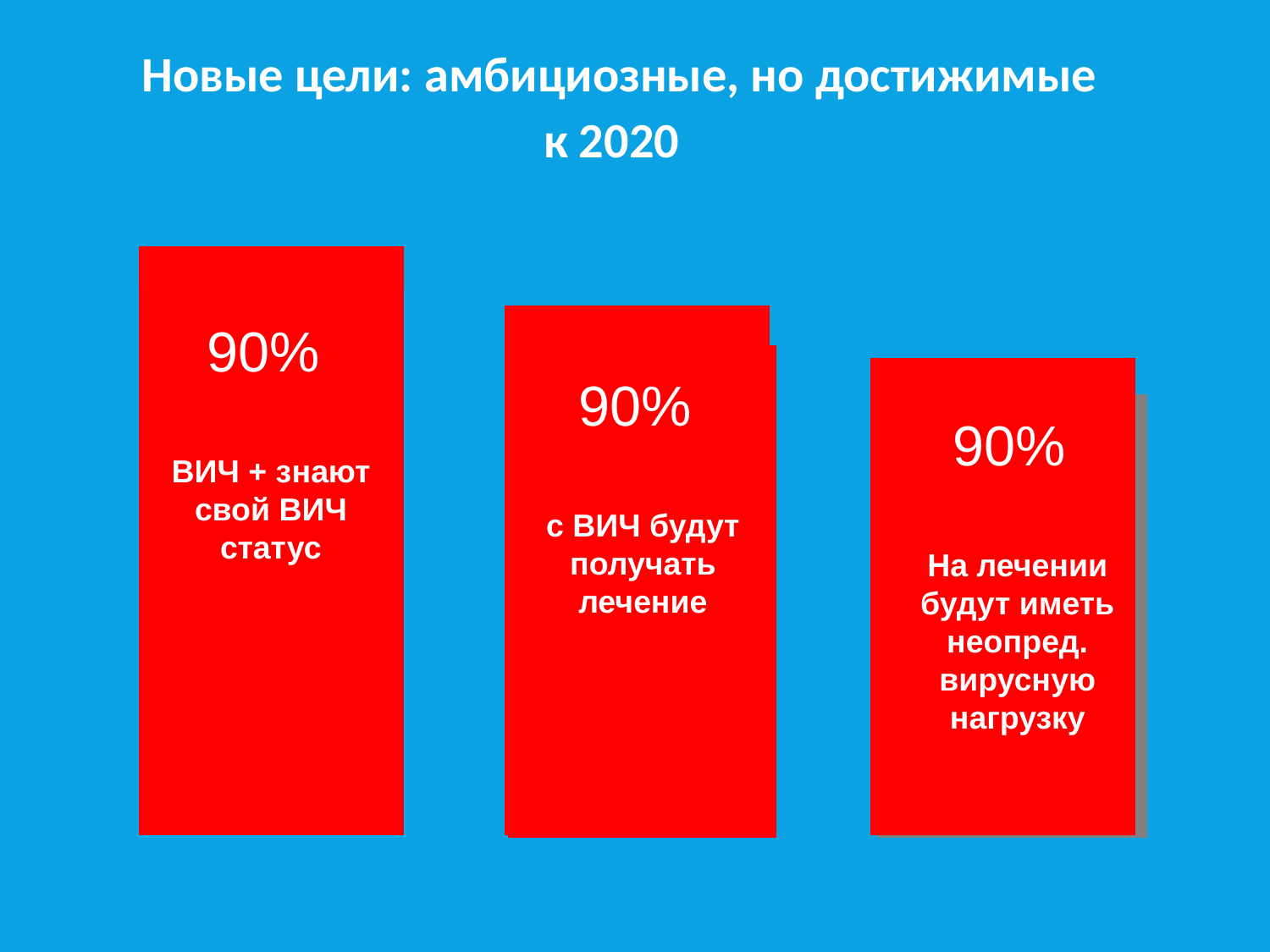
What value is shown on the bar labelled "ВИЧ + знают свой ВИЧ статус"? 90% What value is shown on the bar labelled "На лечении будут иметь неопред. вирусную нагрузку"? 90% What colour are the bars on the slide? red What is the title of the slide? Новые цели: амбициозные, но достижимые к 2020 What value is shown on the bar labelled "с ВИЧ будут получать лечение"? 90% What kind of chart is shown on the slide? bar chart How many bars are shown on the slide? 3 Is the value for "ВИЧ + знают свой ВИЧ статус" greater or less than 100%? less Is the value for "с ВИЧ будут получать лечение" greater or less than 50%? greater